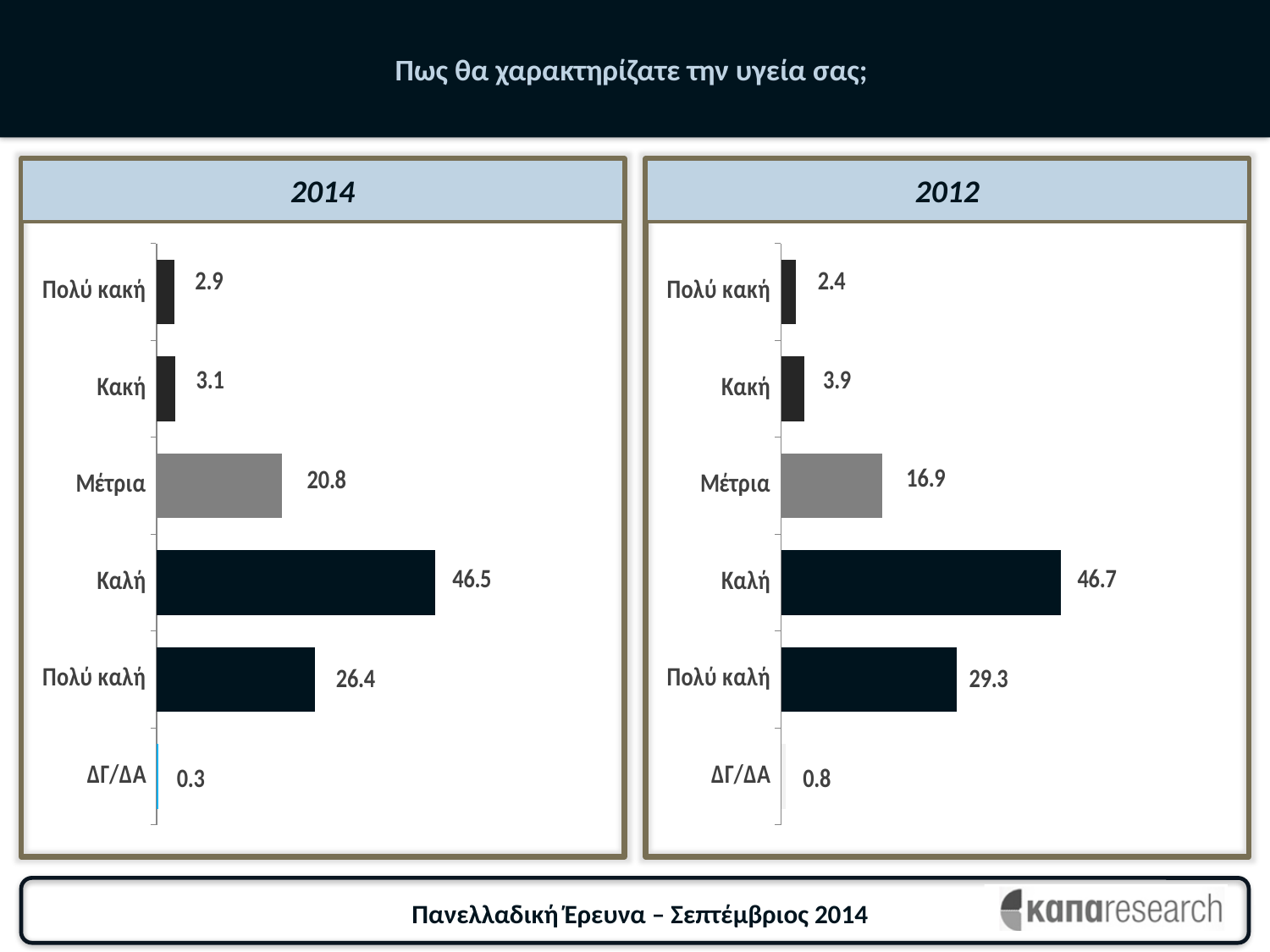
Which is larger: the value for Μέτρια in the 2014 chart or in the 2012 chart? 2014 In the 2012 chart, what is the value for Πολύ καλή? 29.3 In the 2014 chart, what is the value for ΔΓ/ΔΑ? 0.3 How many categories does the 2014 chart show? 6 In the 2014 chart, which category has the highest value? Καλή In the 2012 chart, which category has the lowest value? ΔΓ/ΔΑ In the 2012 chart, what is the value for Μέτρια? 16.9 In the 2014 chart, what is the value for Καλή? 46.5 In the 2014 chart, what is the difference between the values for Καλή and Πολύ καλή? 20.1 In the 2012 chart, what is the difference between the values for Κακή and Πολύ κακή? 1.5 What is the title of the slide? Πως θα χαρακτηρίζατε την υγεία σας; What kind of chart is the 2012 chart? bar chart